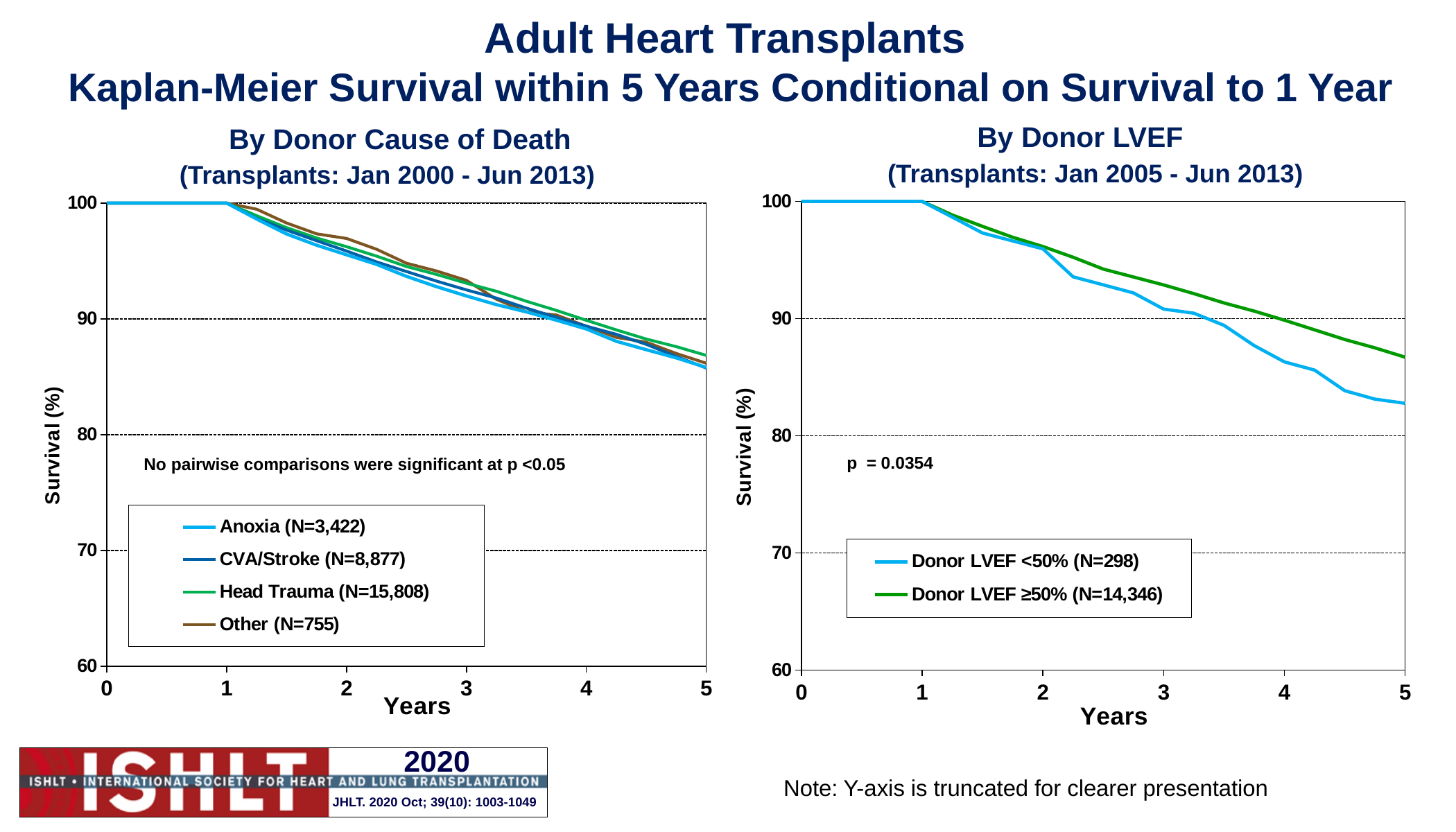
How many series does the legend of the 'By Donor Cause of Death' chart list? 4 In the 'By Donor LVEF' chart, do the survival curves rise or fall as years increase? Fall In the 'By Donor Cause of Death' chart, is the survival value for Head Trauma at 3 years greater or less than 90? greater In the 'By Donor Cause of Death' chart, is the survival value for Anoxia at 5 years greater or less than 90? less What p-value is shown on the 'By Donor LVEF' chart? p = 0.0354 According to the legend of the 'By Donor Cause of Death' chart, what is the N for Head Trauma? 15,808 In the 'By Donor LVEF' chart, is the survival value for Donor LVEF <50% at 5 years greater or less than 90? less In the 'By Donor LVEF' chart, which series has higher survival at 5 years, Donor LVEF <50% or Donor LVEF ≥50%? Donor LVEF ≥50% In the 'By Donor Cause of Death' chart, which series has the highest survival at 2 years? Other How many series does the legend of the 'By Donor LVEF' chart list? 2 What kind of chart is the 'By Donor Cause of Death' chart on the left? Line chart